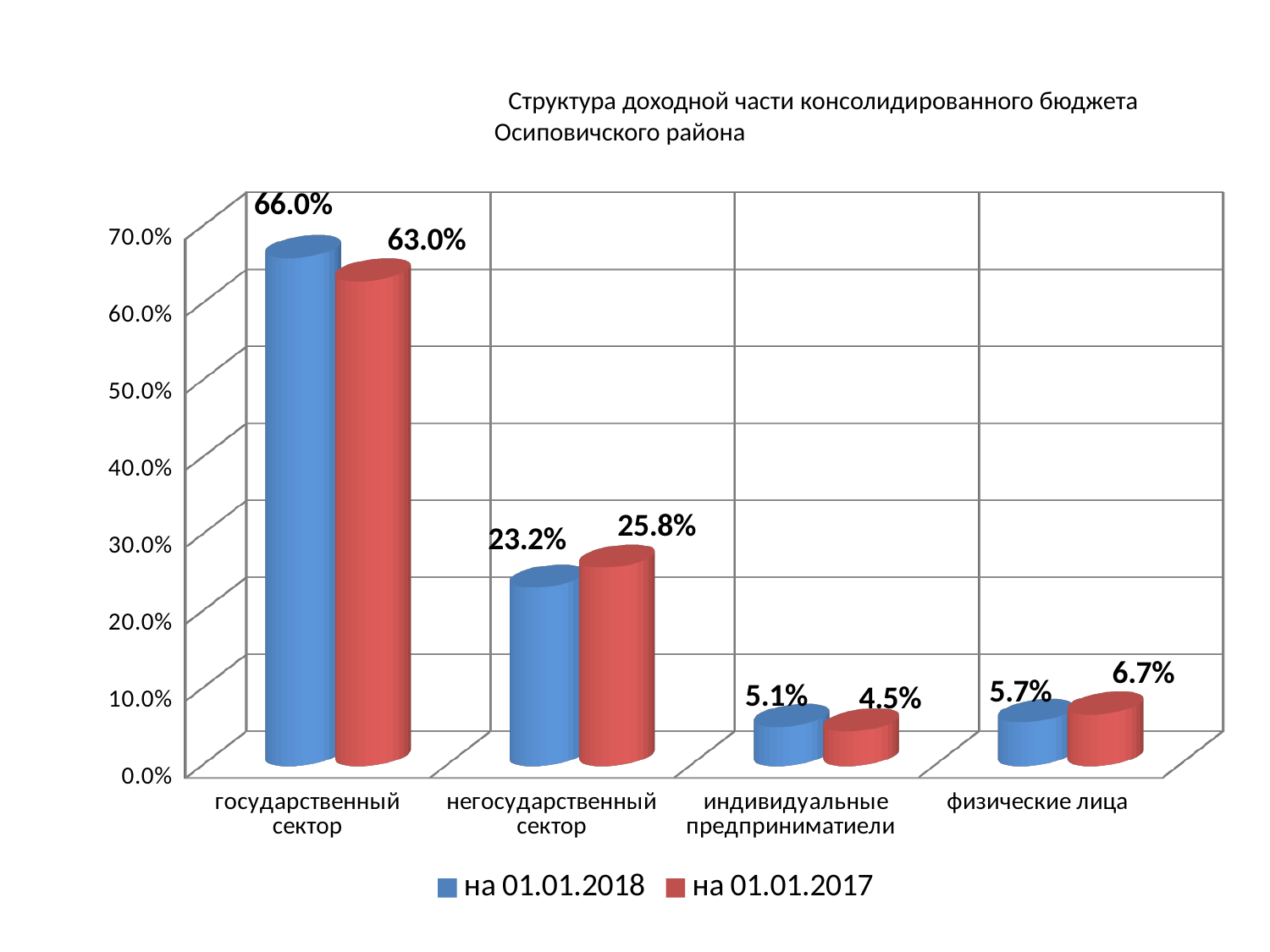
What is the value for государственный сектор in the series на 01.01.2018? 66.0% How many series does the legend list? 2 What kind of chart is shown on the slide? bar chart What is the value for индивидуальные предпринимателли in the series на 01.01.2018? 5.1% Which colour represents the series на 01.01.2017? red Which is larger for негосударственный сектор: the value на 01.01.2018 or на 01.01.2017? на 01.01.2017 Which category has the highest value in the series на 01.01.2017? государственный сектор What is the value for физические лица in the series на 01.01.2017? 6.7% What is the value for негосударственный сектор in the series на 01.01.2017? 25.8% What is the difference between the на 01.01.2018 and на 01.01.2017 values for государственный сектор? 3.0% How many categories are shown on the x axis? 4 Which category has the lowest value in the series на 01.01.2018? индивидуальные предприниматиели